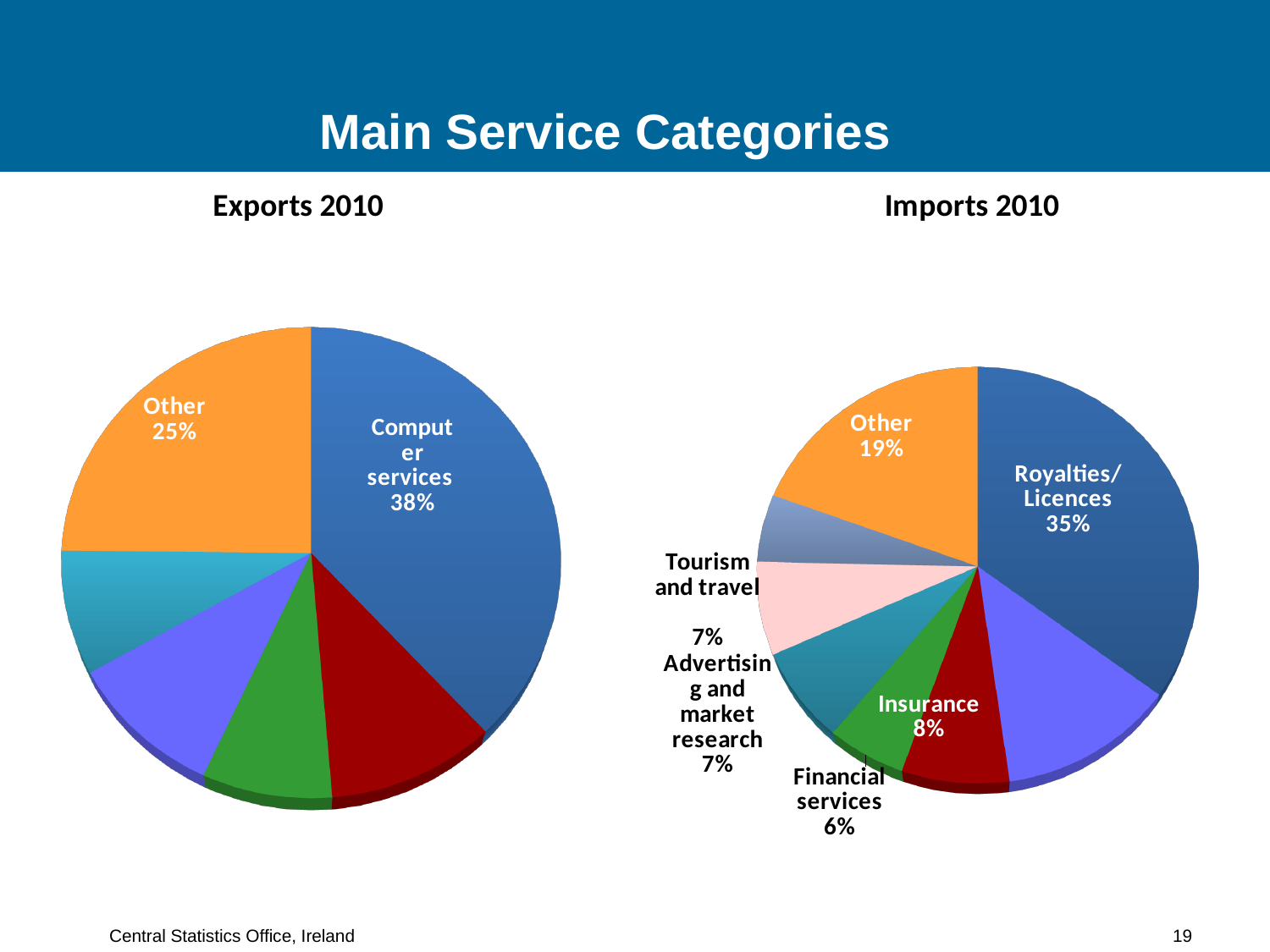
In the Exports 2010 pie chart, what share is Computer services? 38% What type of chart is used for Exports 2010 and Imports 2010? Pie chart In the Imports 2010 pie chart, how many percentage points larger is Royalties/Licences than Other? 16 percentage points In the Exports 2010 pie chart, how many percentage points larger is Computer services than Other? 13 percentage points In the Imports 2010 pie chart, what share is Financial services? 6% In the Imports 2010 pie chart, what share is the Other category? 19% In the Imports 2010 pie chart, which category has the largest share? Royalties/Licences In the Imports 2010 pie chart, which is larger: Insurance or Financial services? Insurance In the Imports 2010 pie chart, what share is Insurance? 8% In the Exports 2010 pie chart, which labelled category has the largest share? Computer services In the Imports 2010 pie chart, what share is Royalties/Licences? 35% In the Exports 2010 pie chart, what share is the Other category? 25%